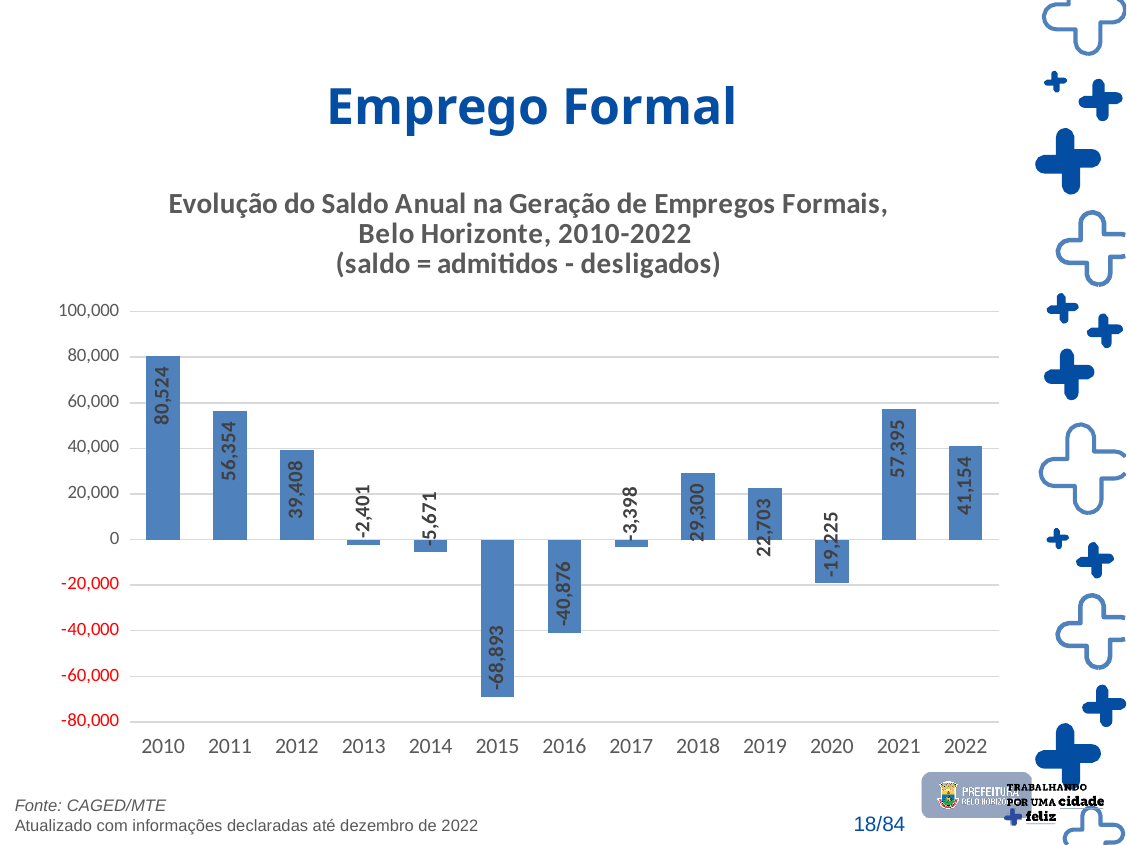
Which year has the lowest value? 2015 What is the difference between the values for 2010 and 2011? 24,170 How many years are shown on the x axis? 13 Which year has the highest value? 2010 What is the value for 2021? 57,395 Which is larger, the value for 2018 or the value for 2019? 2018 What kind of chart is shown? bar chart What is the value for 2010? 80,524 What is the source cited below the chart? CAGED/MTE Is the value for 2022 greater or less than 40,000? greater Do the values rise or fall from 2010 to 2013? fall What is the value for 2015? -68,893